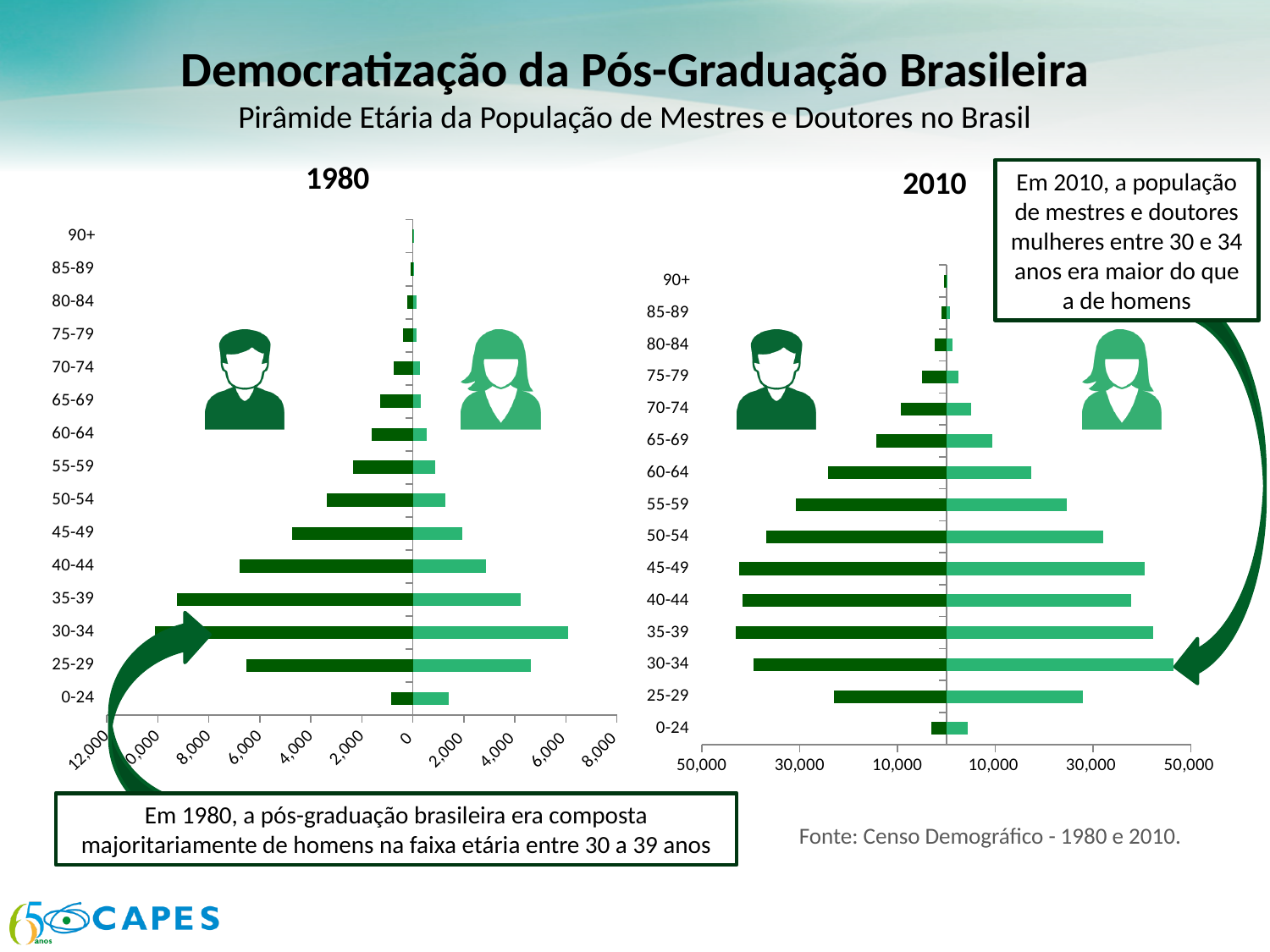
On the 1980 chart, is the value for women aged 40-44 greater or less than 2,000? greater What kind of chart is the 1980 chart on the left? Bar chart How many age groups are shown on the 1980 chart? 15 On the 2010 chart, which age group has the longest bar for women (light green, right side)? 30-34 On the 2010 chart, is the value for men aged 0-24 greater or less than 10,000? less On the 2010 chart, do the bars get longer or shorter as the age groups go from 45-49 up to 90+? Shorter On the 1980 chart, which age group has the shortest bars? 90+ On the 2010 chart, which is larger for women: the 45-49 group or the 50-54 group? 45-49 On the 1980 chart, is the value for men aged 30-34 greater or less than 8,000? greater On the 1980 chart, which is larger for women: the 30-34 group or the 25-29 group? 30-34 On the 1980 chart, which age group has the longest bar for women (light green, right side)? 30-34